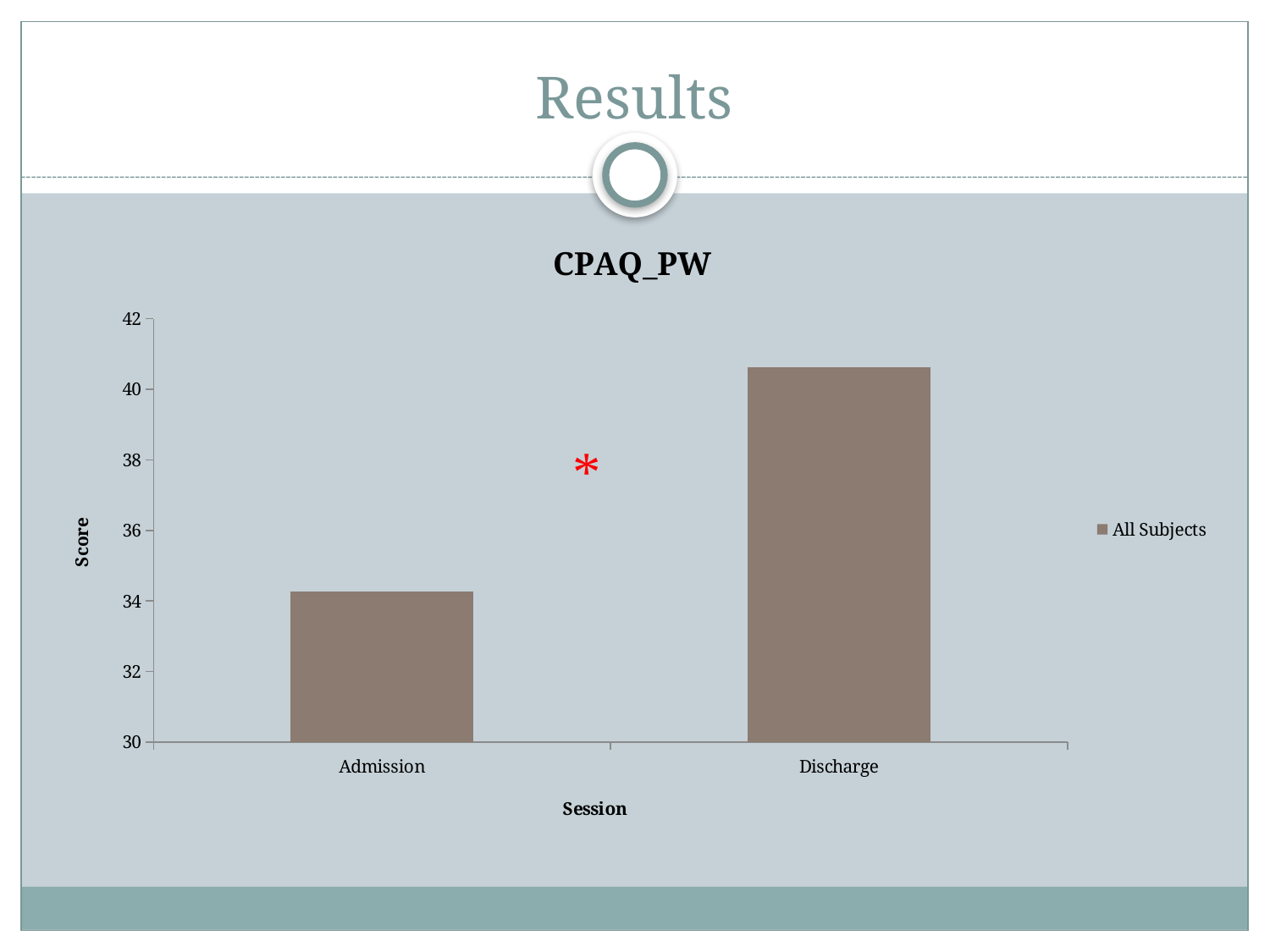
How many categories are shown on the x axis? 2 How many series does the legend list? 1 What is the name of the series in the legend? All Subjects Is the score for Discharge greater or less than 40? greater Is the score for Admission greater or less than 36? less Which session has the highest score? Discharge Which is larger, the score at Admission or at Discharge? Discharge What is the title of the chart? CPAQ_PW What kind of chart is shown on the slide? bar chart Which session has the lowest score? Admission Do the scores rise or fall from Admission to Discharge? rise